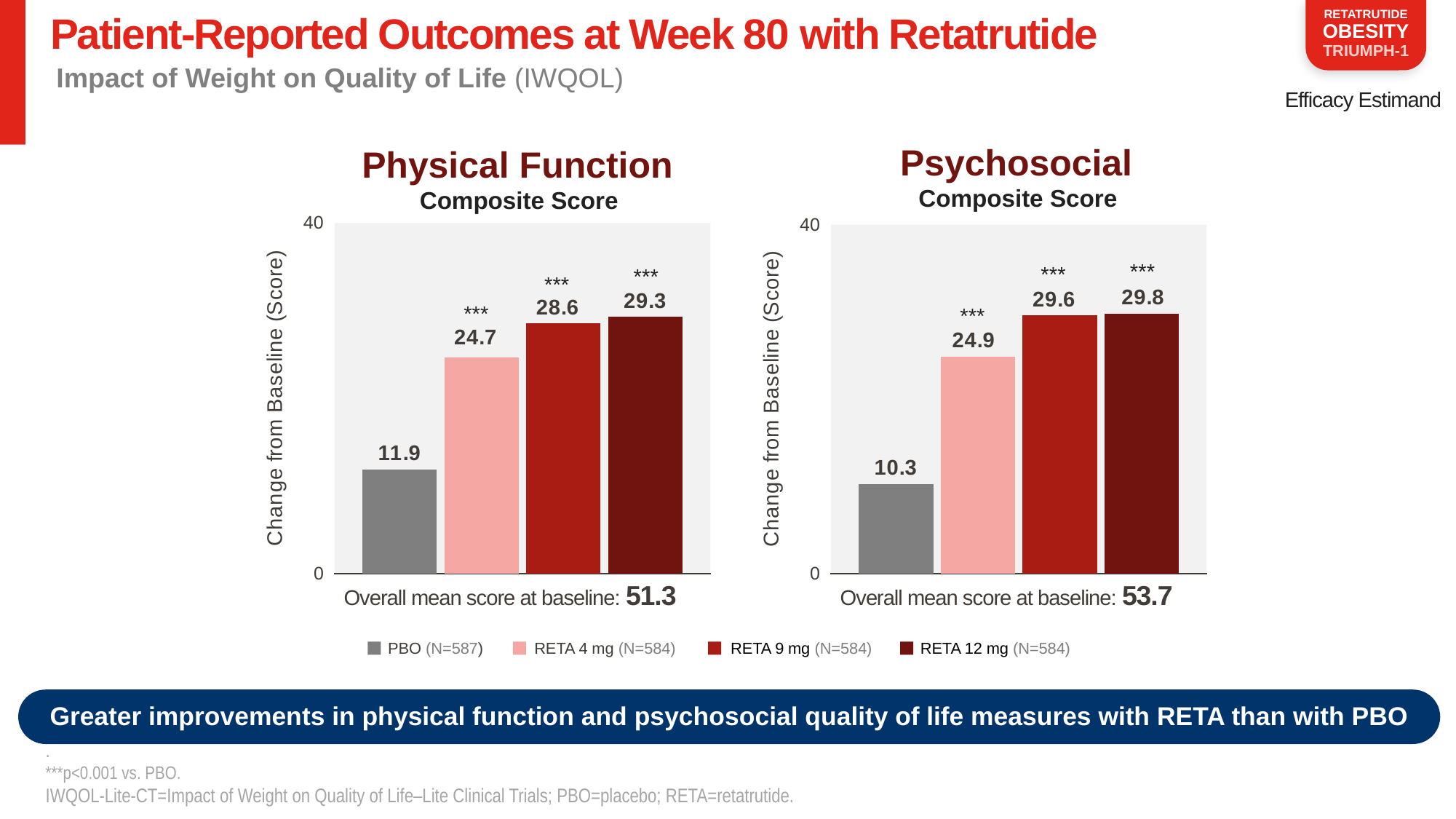
In the Physical Function Composite Score chart, which group has the highest change from baseline? RETA 12 mg In the Physical Function Composite Score chart, what is the change from baseline for PBO? 11.9 What is the overall mean score at baseline shown under the Psychosocial Composite Score chart? 53.7 What type of chart is the Psychosocial Composite Score chart? Bar chart In the Psychosocial Composite Score chart, what is the change from baseline for RETA 12 mg? 29.8 In the Physical Function Composite Score chart, what is the change from baseline for RETA 4 mg? 24.7 In the Physical Function Composite Score chart, what is the difference between the RETA 9 mg and PBO values? 16.7 In the Psychosocial Composite Score chart, what is the difference between the RETA 4 mg and PBO values? 14.6 How many bars are shown in the Physical Function Composite Score chart? 4 How many groups does the legend list? 4 In the Psychosocial Composite Score chart, which is larger, the value for RETA 4 mg or the value for PBO? RETA 4 mg In the Psychosocial Composite Score chart, which group has the lowest change from baseline? PBO